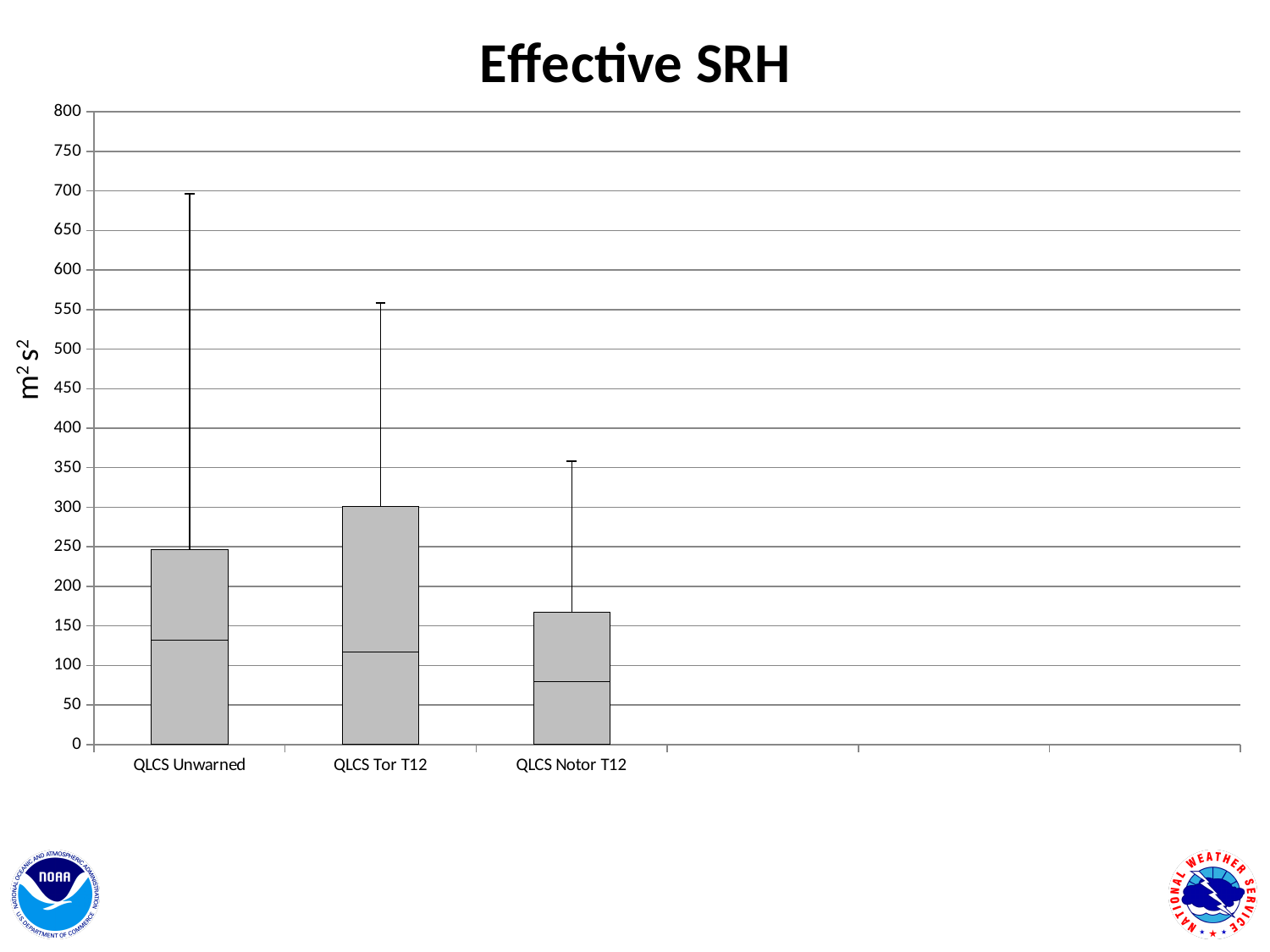
What is the label on the vertical axis of the chart? m² s² What kind of chart is shown on the slide? box-and-whisker chart Is the top of the upper whisker for QLCS Unwarned greater or less than 650? greater What is the title of the chart? Effective SRH Is the top of the box for QLCS Tor T12 greater or less than 250? greater Is the top of the box for QLCS Unwarned larger or smaller than the top of the box for QLCS Notor T12? larger Is the top of the box for QLCS Notor T12 greater or less than 200? less Which category has the highest upper whisker? QLCS Unwarned Which category has the highest top of its box? QLCS Tor T12 Which category has the lowest top of its box? QLCS Notor T12 How many categories are shown on the x axis of the chart? 3